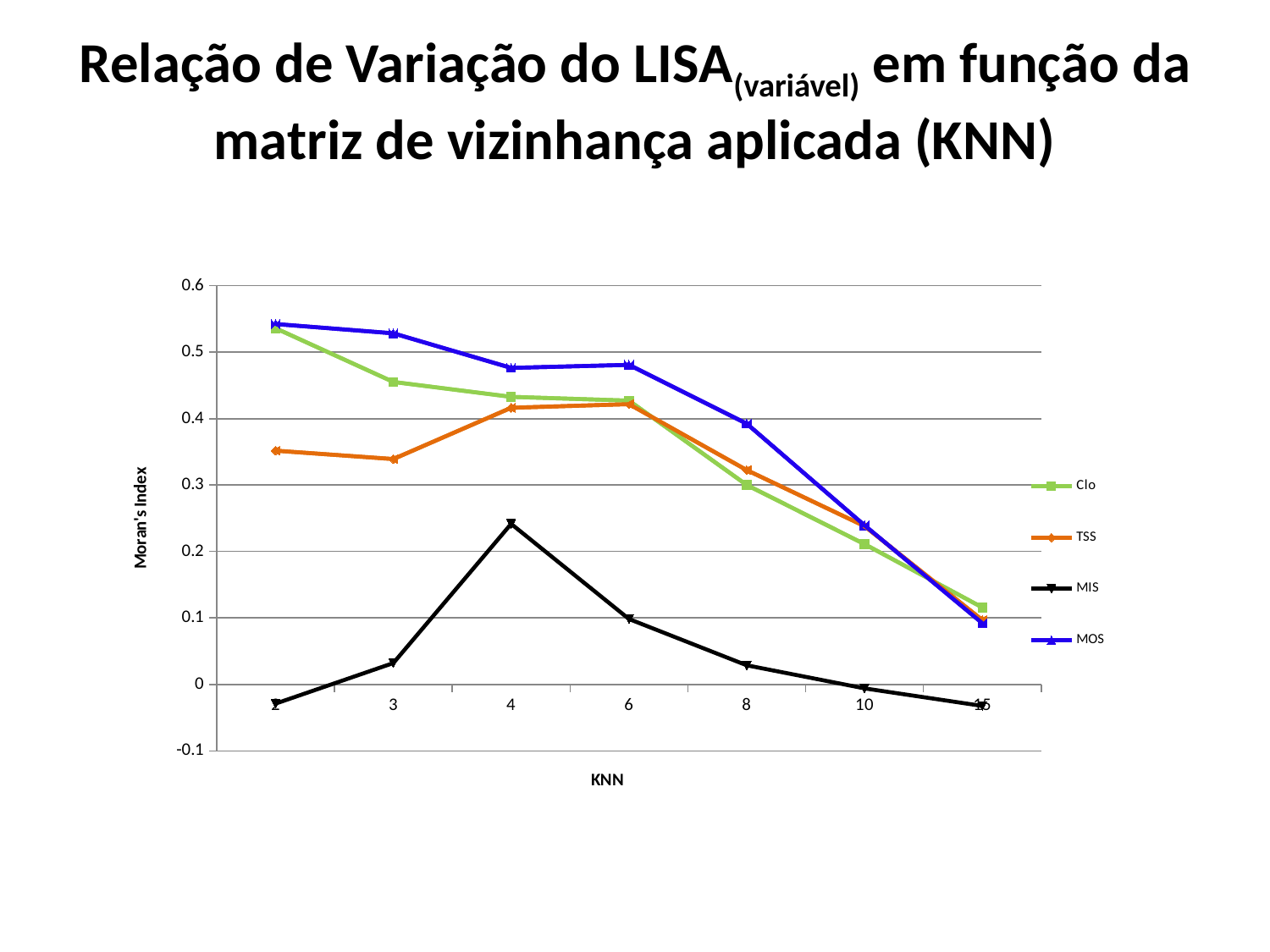
At KNN = 4, which is larger, the value for MOS or the value for TSS? MOS Does the MOS series rise or fall as KNN increases? fall What is the title of the vertical axis? Moran's Index Which series has the highest value at KNN = 6? MOS Which series has the lowest value at KNN = 8? MIS Is the value for MIS at KNN = 6 greater or less than 0.2? less What is the title of the horizontal axis? KNN Is the value for MIS at KNN = 4 greater or less than 0.2? greater What kind of chart is shown on the slide? line chart Is the value for TSS at KNN = 3 greater or less than 0.4? less How many series does the legend list? 4